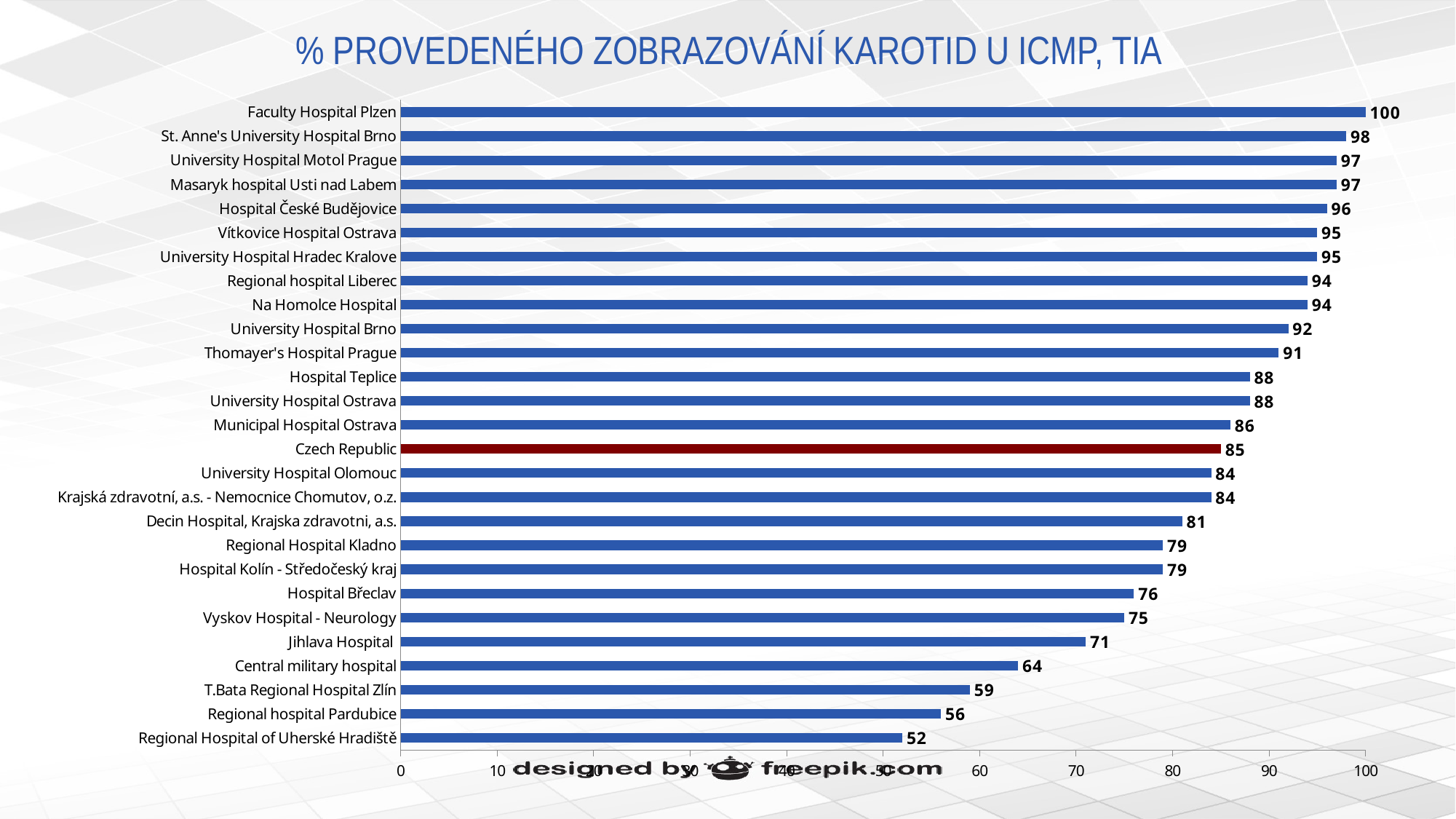
What is the value for Regional hospital Pardubice? 56 How many categories are plotted in the chart? 27 What is the difference between the values for Faculty Hospital Plzen and Regional Hospital of Uherské Hradiště? 48 What is the value for Jihlava Hospital? 71 Which category has the highest value? Faculty Hospital Plzen Which bar is shown in a different colour (dark red) from the others? Czech Republic What kind of chart is shown on the slide? Bar chart Which is larger, the value for Hospital Teplice or the value for Hospital Břeclav? Hospital Teplice What is the difference between the values for Czech Republic and Central military hospital? 21 What is the value for Czech Republic? 85 What is the value for Faculty Hospital Plzen? 100 Which hospital has the lowest value? Regional Hospital of Uherské Hradiště